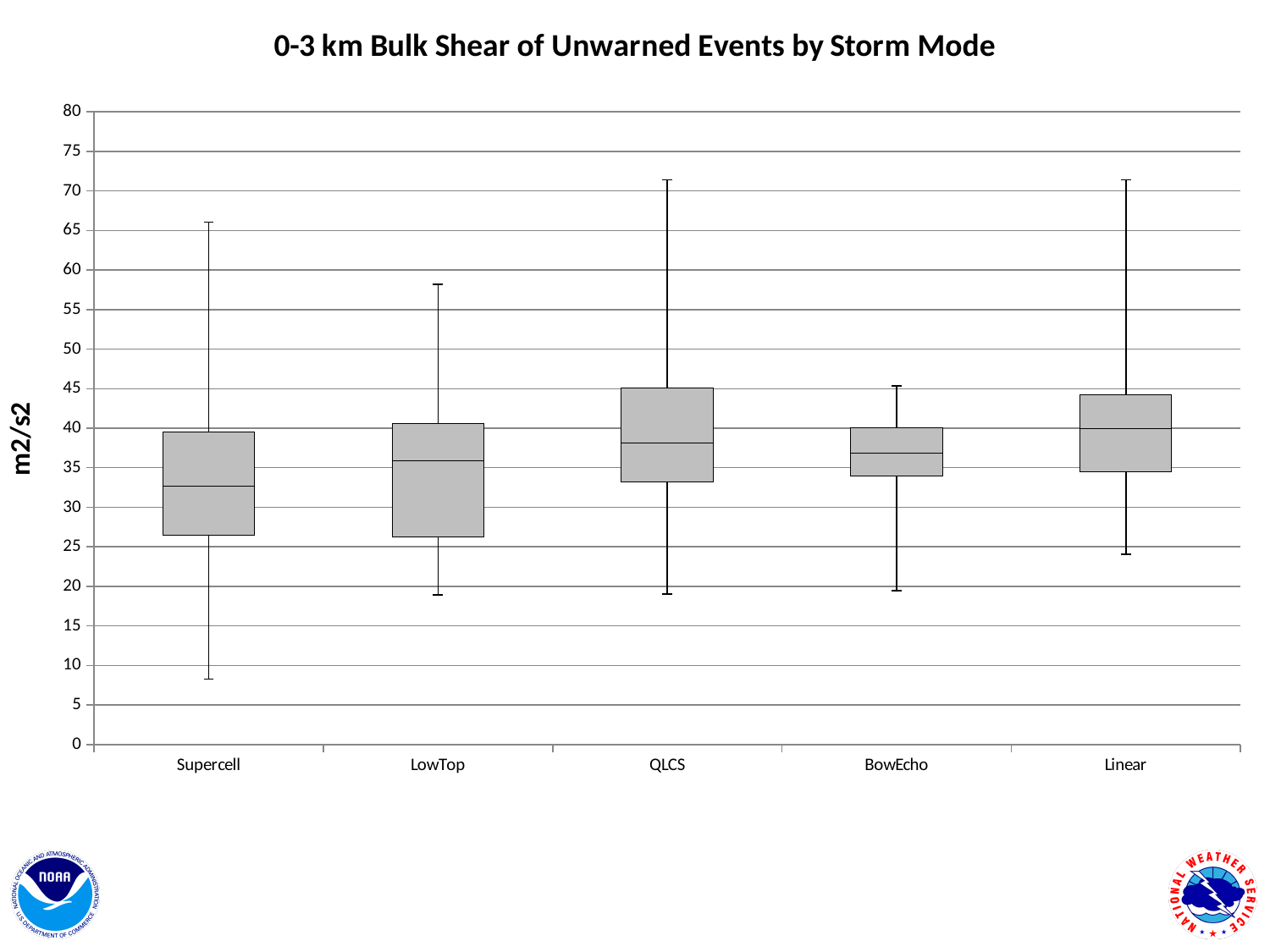
Which has the larger median value, Supercell or LowTop? LowTop Which storm mode has the highest median 0-3 km bulk shear? Linear Is the median value for Supercell greater or less than 35? less What kind of chart is shown on the slide? Box plot (box-and-whisker chart) Is the median value for Linear greater or less than 35? greater How many storm mode categories are shown on the x axis? 5 Is the upper whisker value for QLCS greater or less than 65? greater Which storm mode has the lowest minimum whisker value? Supercell Which storm mode has the lowest median 0-3 km bulk shear? Supercell Which storm mode has the shortest box (narrowest interquartile range)? BowEcho